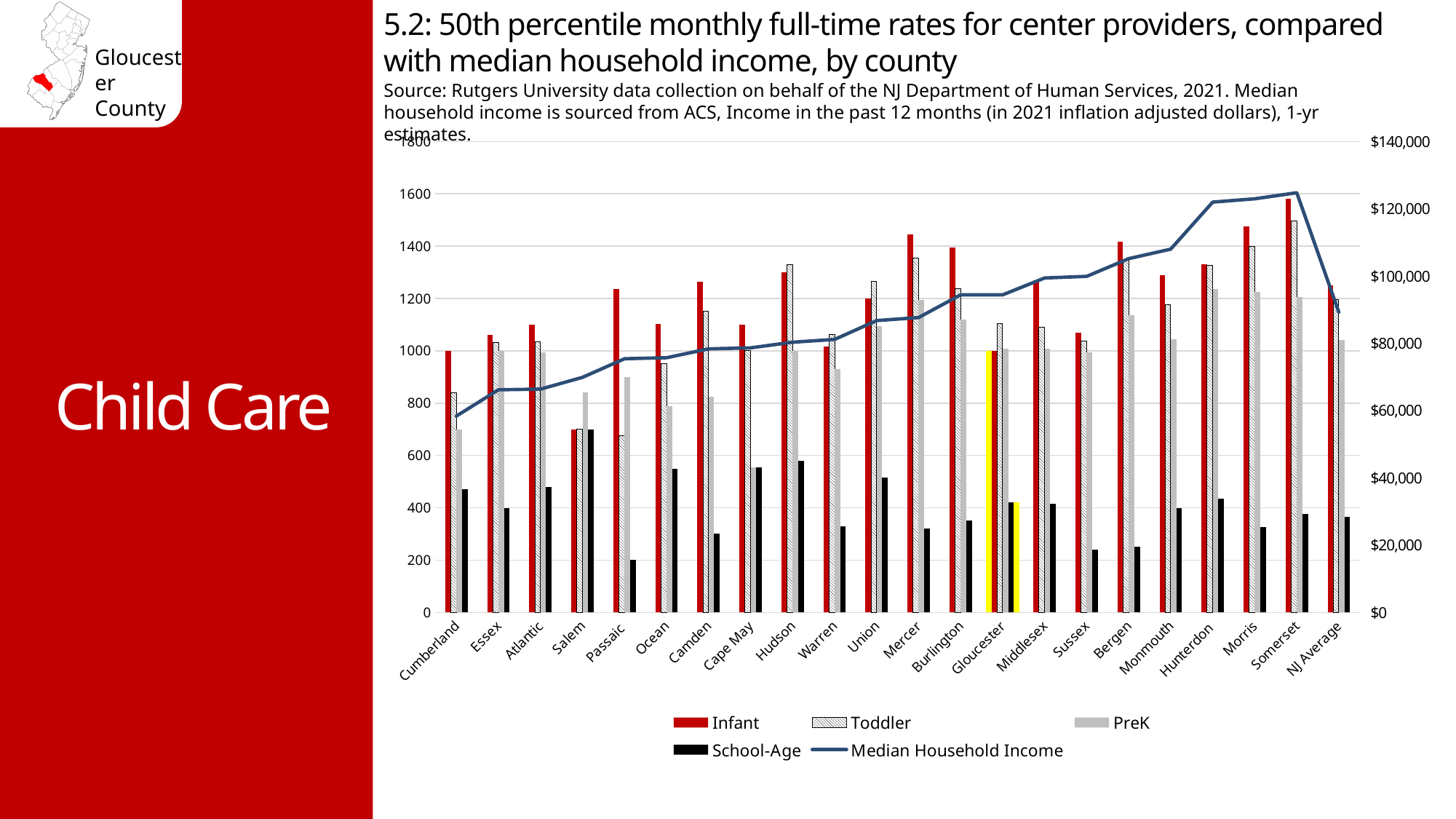
How many categories are shown along the x axis? 22 Which county has the highest Infant rate? Somerset Which county's bars are highlighted in yellow on the chart? Gloucester Which is larger, the School-Age rate for Salem or the School-Age rate for Passaic? Salem How many series does the legend list? 5 Is the Infant rate for Salem greater or less than 800? less Which county has the lowest Median Household Income? Cumberland Is the Infant rate for Somerset greater or less than 1400? greater Does the Median Household Income line generally rise or fall from Cumberland to Somerset? rise Which county has the lowest Infant rate? Salem Is the Median Household Income for Hunterdon greater or less than $100,000? greater What kind of chart is shown on the slide? bar chart with a line